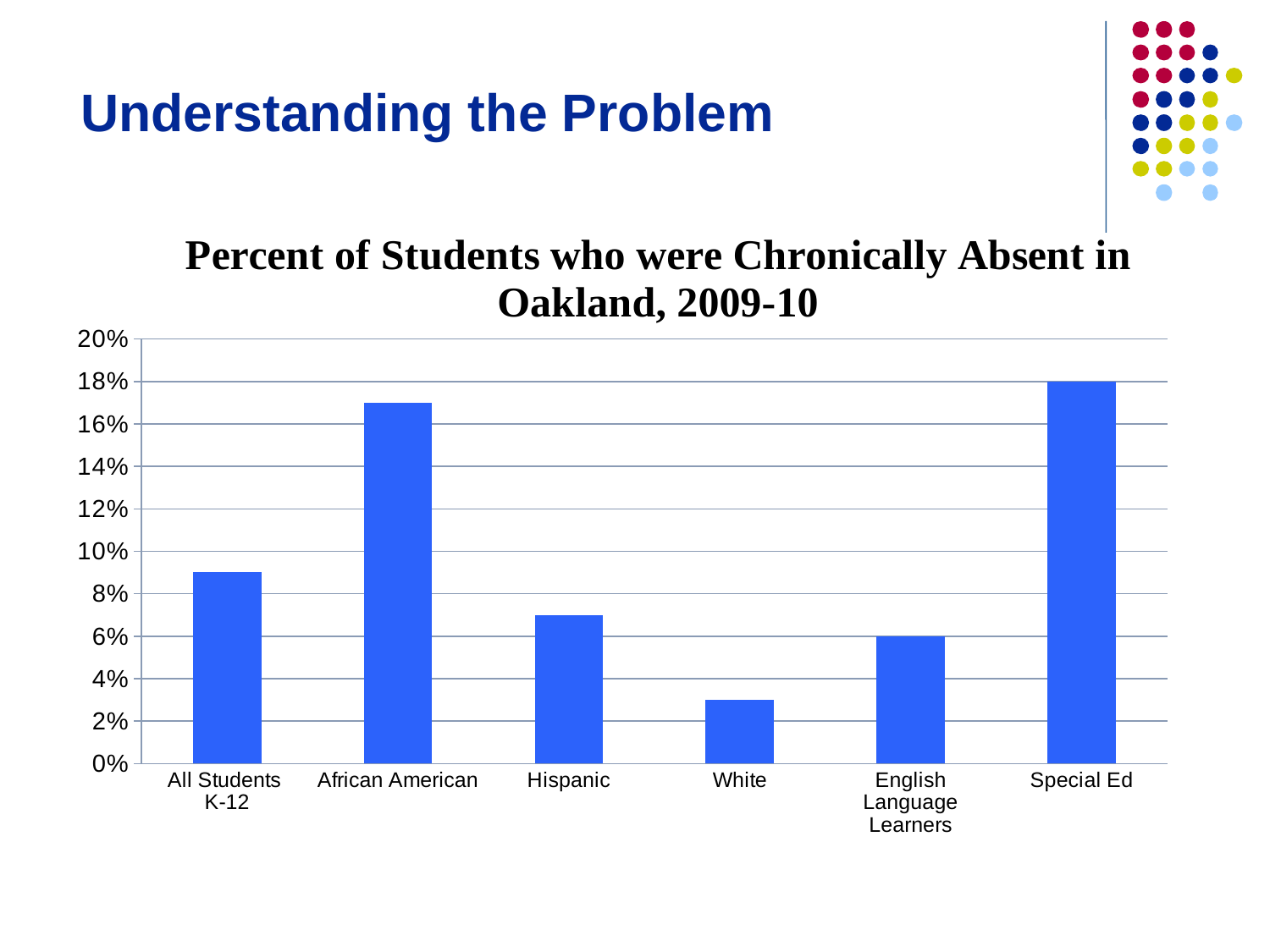
What is the percent of Special Ed students who were chronically absent? 18% What is the percent of English Language Learners who were chronically absent? 6% Is the value for White students greater or less than 4%? less Is the value for Hispanic students greater or less than 8%? less Which student group has the lowest percent of chronically absent students? White Which student group has the highest percent of chronically absent students? Special Ed Is the value for African American students greater or less than 16%? greater What is the title of the chart? Percent of Students who were Chronically Absent in Oakland, 2009-10 What type of chart is shown on the slide? bar chart How many student groups are shown on the x axis of the chart? 6 Which is larger, the value for Hispanic students or the value for White students? Hispanic